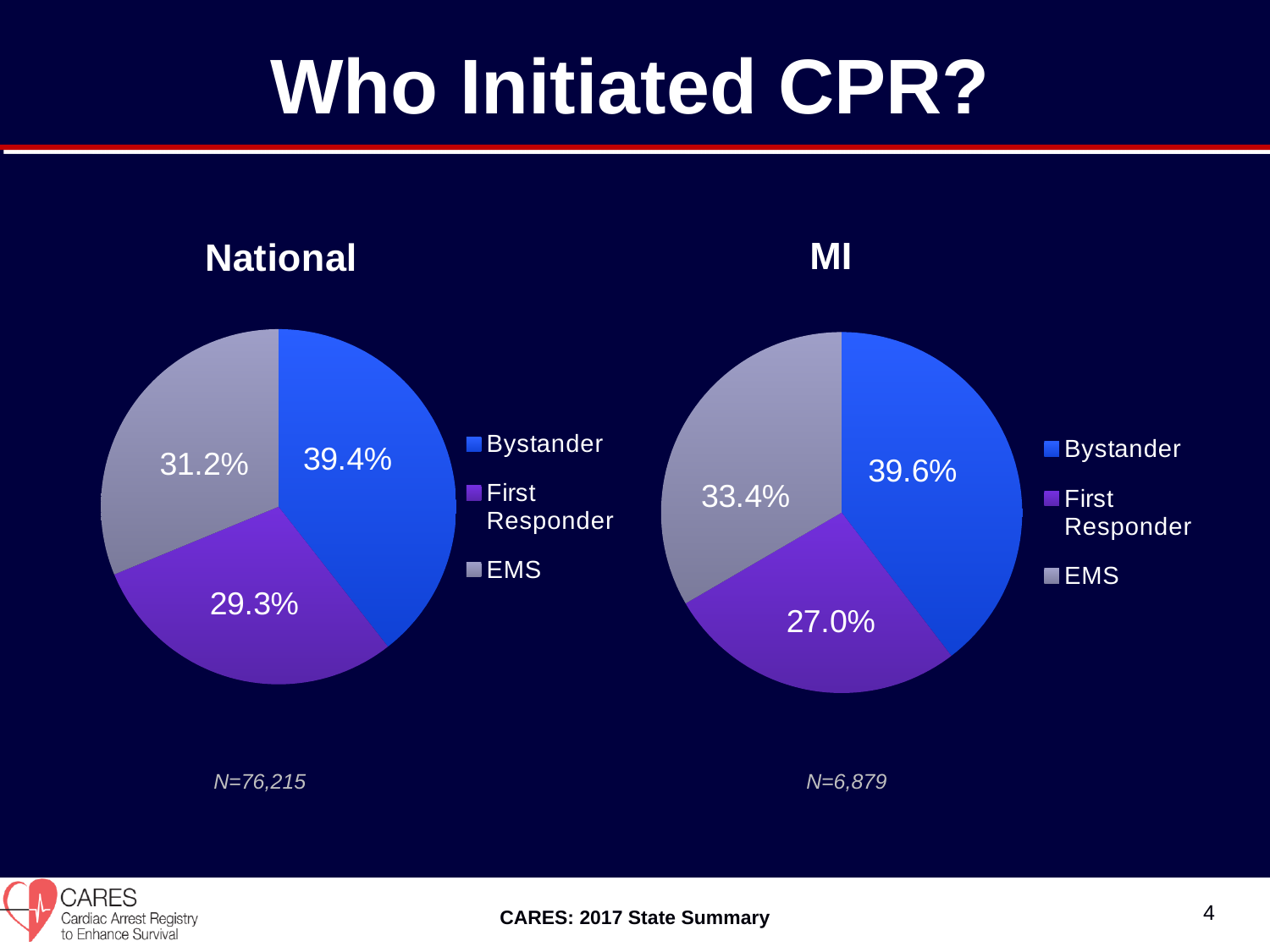
In the MI pie chart, what share of CPR was initiated by First Responders? 27.0% What is the title of the slide containing the two pie charts? Who Initiated CPR? What is the sample size (N) shown under the MI pie chart? N=6,879 How many slices does the MI pie chart have? 3 In the National pie chart, which category has the largest share? Bystander Which is larger: the Bystander share in the National chart or the Bystander share in the MI chart? MI In the MI pie chart, which category has the smallest share? First Responder In the National pie chart, what share of CPR was initiated by Bystanders? 39.4% In the MI pie chart, what share of CPR was initiated by EMS? 33.4% How many entries does the legend of the National chart list? 3 In the National pie chart, what is the difference between the EMS share and the First Responder share? 1.9% What type of chart is used for the National data? Pie chart